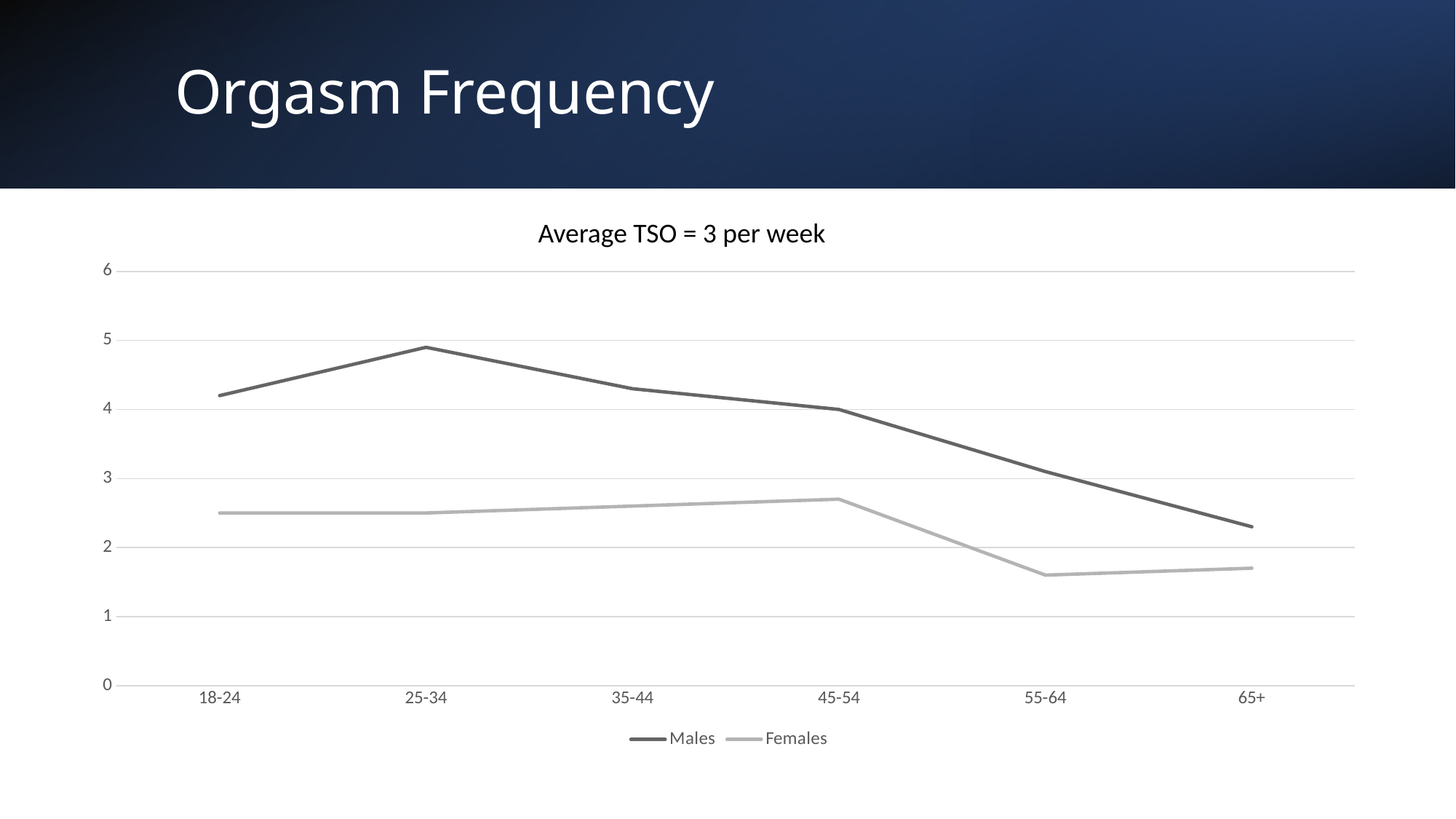
At 18-24, which series has the larger value, Males or Females? Males Which age group has the highest value for Males? 25-34 What is the title of the chart? Average TSO = 3 per week Is the value for Males at 25-34 greater or less than 4? greater Do the Males values rise or fall from 25-34 to 65+? fall How many series does the legend list? 2 How many age groups are shown on the x axis? 6 What kind of chart is shown on the slide? line chart Is the value for Males at 55-64 greater or less than 4? less Which age group has the highest value for Females? 45-54 Which age group has the lowest value for Males? 65+ Is the value for Females at 55-64 greater or less than 2? less